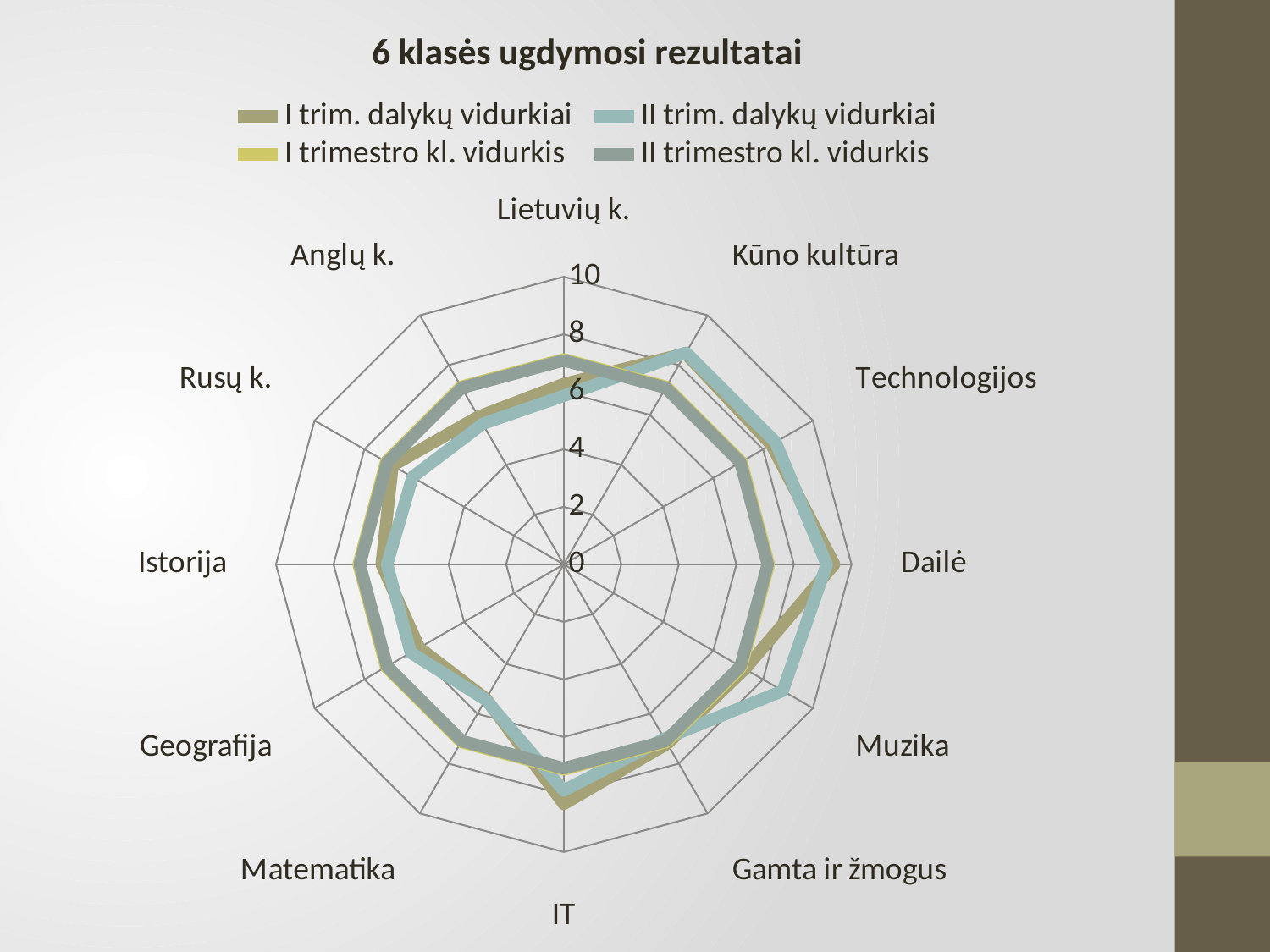
Is the value for Istorija in the I trim. dalykų vidurkiai series greater or less than 8? less How many subject categories are plotted around the radar chart? 12 What is the maximum value shown on the radar chart's axis scale? 10 Is the value for Kūno kultūra in the II trim. dalykų vidurkiai series greater or less than 8? greater Is the value for Lietuvių k. in the I trim. dalykų vidurkiai series greater or less than 8? less What is the title of the chart? 6 klasės ugdymosi rezultatai Which subject has the highest value in the I trim. dalykų vidurkiai series? Dailė What kind of chart is shown on the slide? radar chart How many series does the legend list? 4 In the I trim. dalykų vidurkiai series, which is larger: the value for Dailė or the value for Lietuvių k.? Dailė